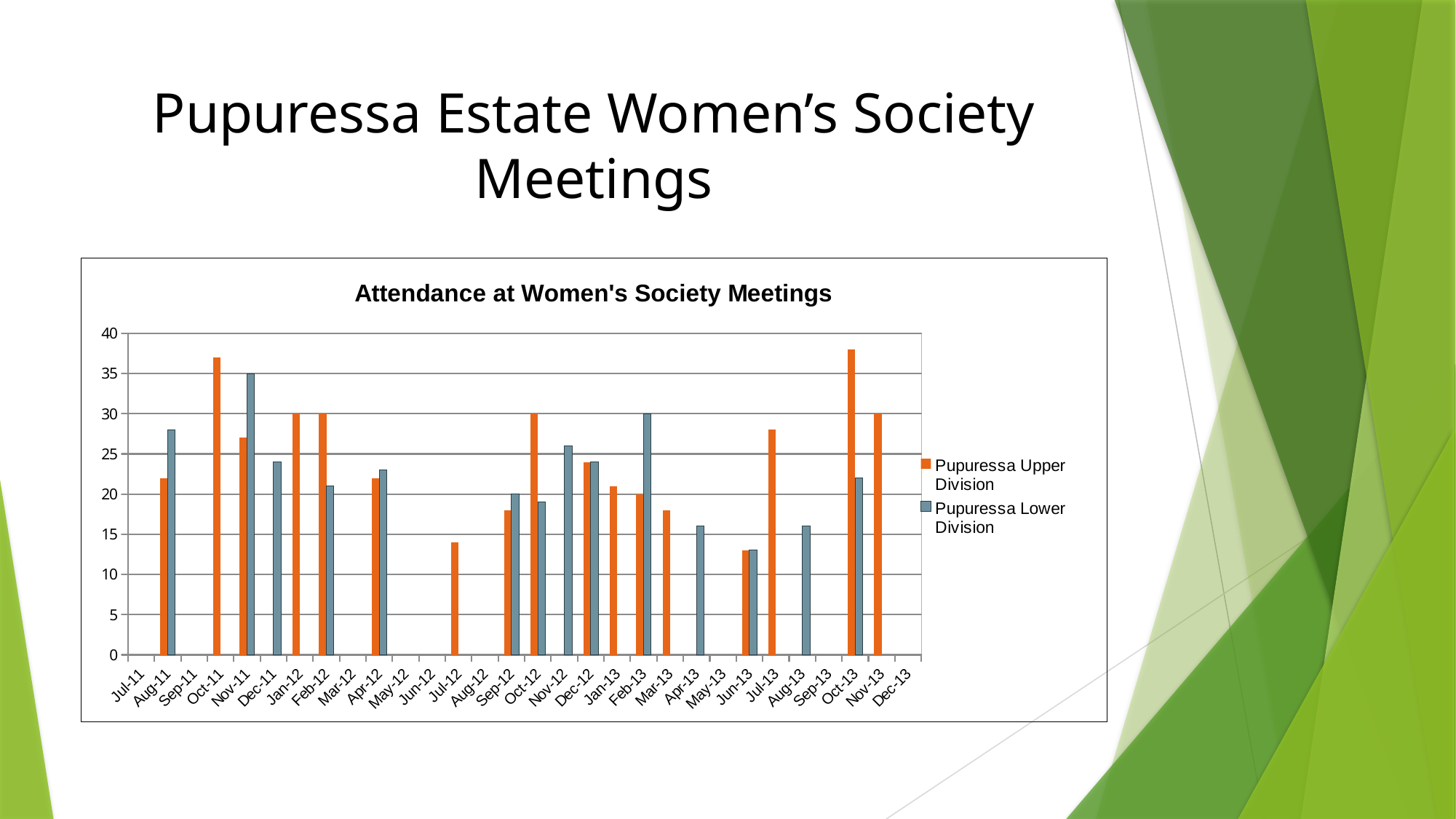
Is the attendance for Pupuressa Upper Division in Oct-11 greater or less than 35? greater In Nov-11, which division had the higher attendance? Pupuressa Lower Division Is the attendance for Pupuressa Lower Division in Aug-11 greater or less than 25? greater Is the attendance for Pupuressa Upper Division in Jul-12 greater or less than 15? less What is the attendance for Pupuressa Lower Division in Nov-11? 35 For Pupuressa Upper Division, which month had higher attendance, Oct-11 or Nov-11? Oct-11 How many months are labelled along the x axis? 30 What is the attendance for Pupuressa Upper Division in Jan-12? 30 How many series does the legend list? 2 In which month is the Pupuressa Lower Division attendance highest? Nov-11 What is the title of the chart? Attendance at Women's Society Meetings What kind of chart is shown on the slide? bar chart